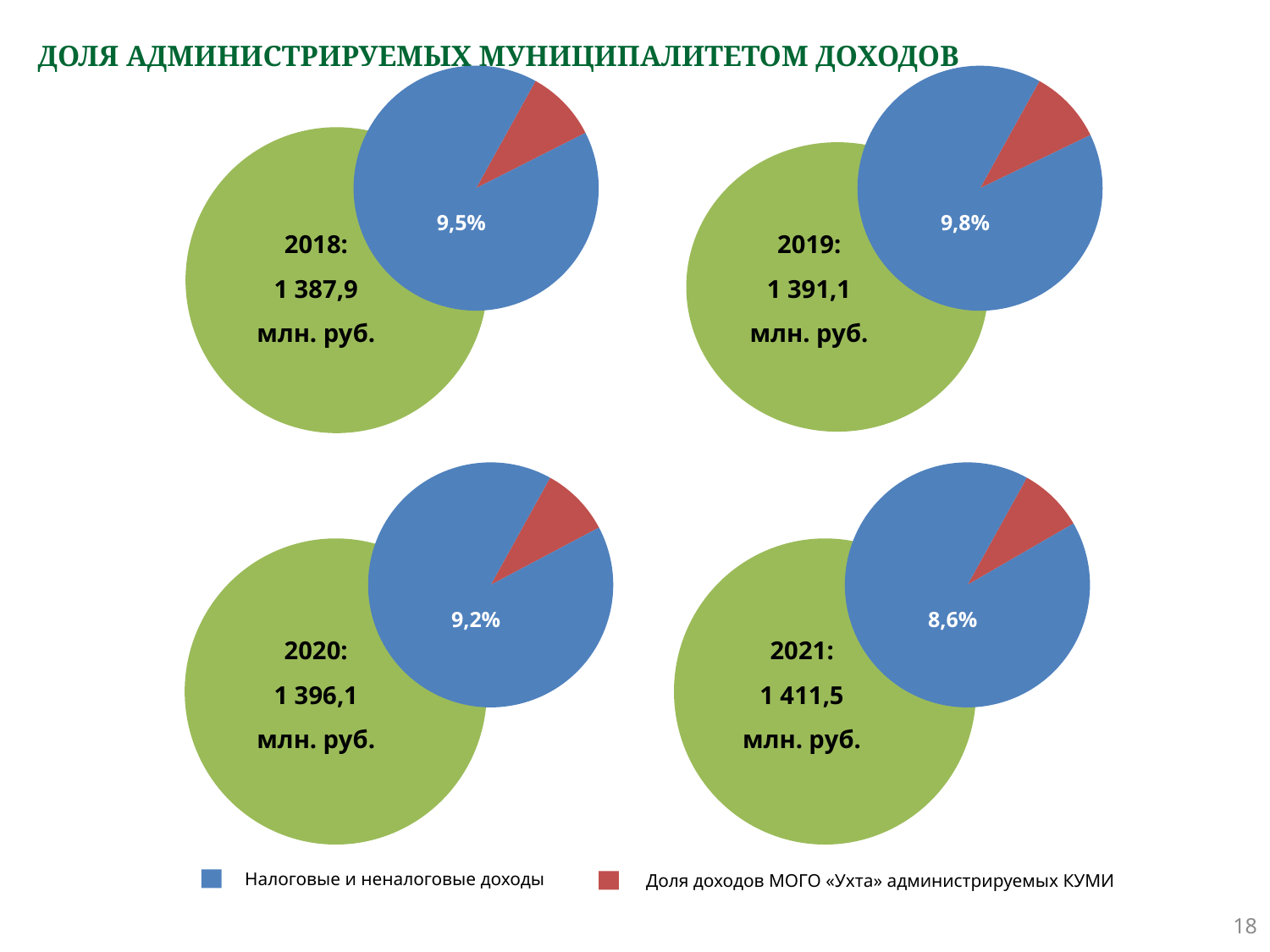
How many entries does the legend at the bottom of the slide list? 2 Which is larger: the labelled share in the 2018 pie chart or in the 2020 pie chart? 2018 From the 2019 pie chart to the 2021 pie chart, does the labelled share of revenues administered by КУМИ rise or fall? Fall Across the four pie charts, which year has the lowest labelled share of revenues administered by КУМИ? 2021 In the 2018 pie chart, what share is labelled on the red slice (Доля доходов МОГО «Ухта» администрируемых КУМИ)? 9,5% Across the four pie charts, which year has the highest labelled share of revenues administered by КУМИ? 2019 What kind of chart is used on this slide to show the share of revenues? Pie chart In the 2020 pie chart, what percentage is printed on the chart? 9,2% In the 2019 pie chart, what percentage is shown for the share of revenues administered by КУМИ? 9,8% How many pie charts are shown on the slide? 4 In the 2021 pie chart, what share is labelled for the red slice? 8,6% What is the difference between the labelled share in the 2019 pie chart and the labelled share in the 2021 pie chart? 1,2%